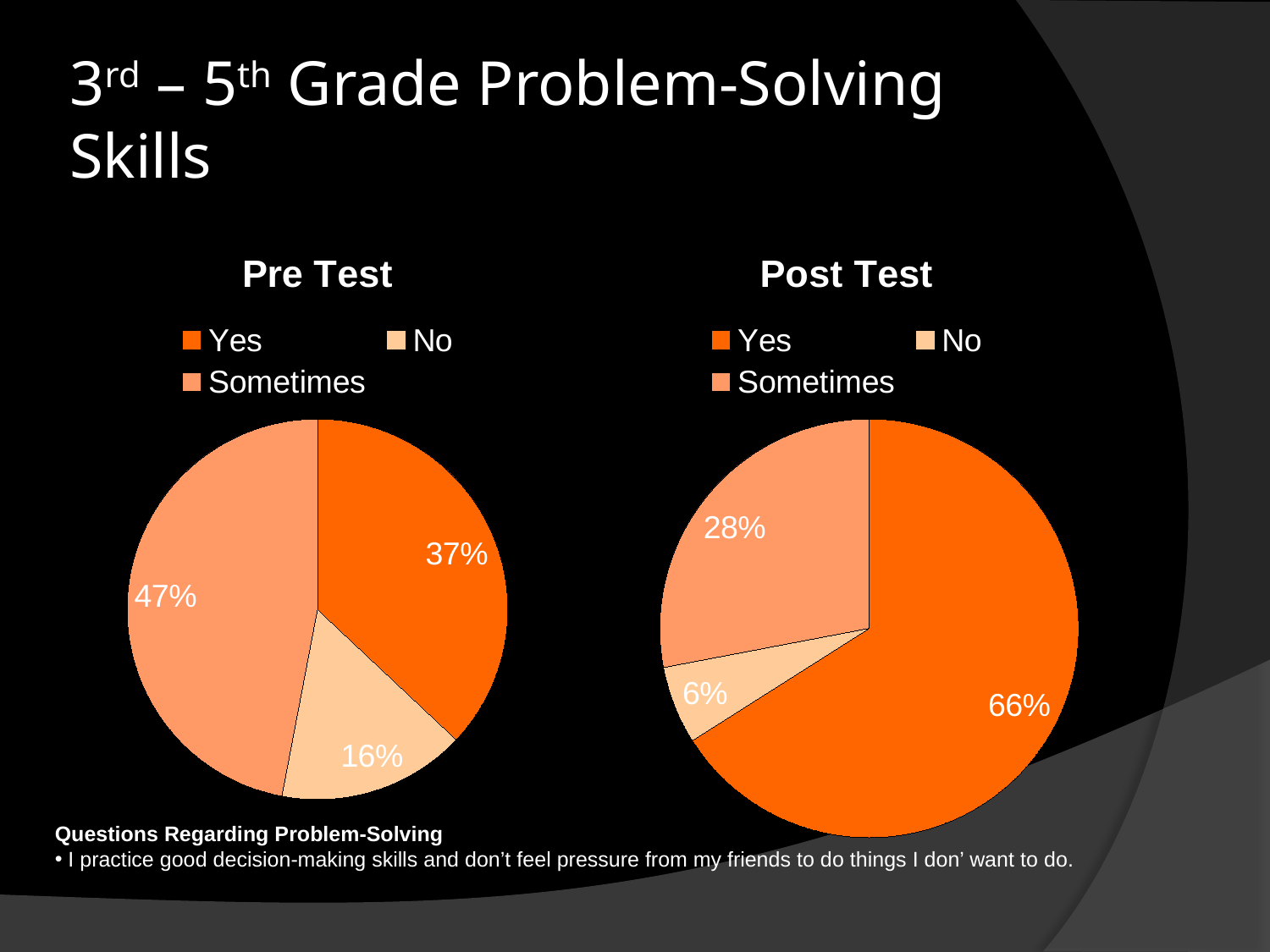
What type of chart is the Pre Test chart? Pie chart How many categories does the Post Test chart show? 3 In the Pre Test chart, which category has the largest share? Sometimes What colour represents the Yes category in the Post Test chart's legend? Orange In the Pre Test chart, what percentage of responses were Yes? 37% In the Pre Test chart, what percentage of responses were No? 16% Which is larger: the No share in the Pre Test chart or the No share in the Post Test chart? Pre Test In the Post Test chart, which category has the smallest share? No In the Pre Test chart, what is the difference between the Sometimes share and the No share? 31% In the Post Test chart, what percentage of responses were Yes? 66% In the Post Test chart, what percentage of responses were Sometimes? 28% What is the difference between the Yes share in the Post Test chart and the Yes share in the Pre Test chart? 29%